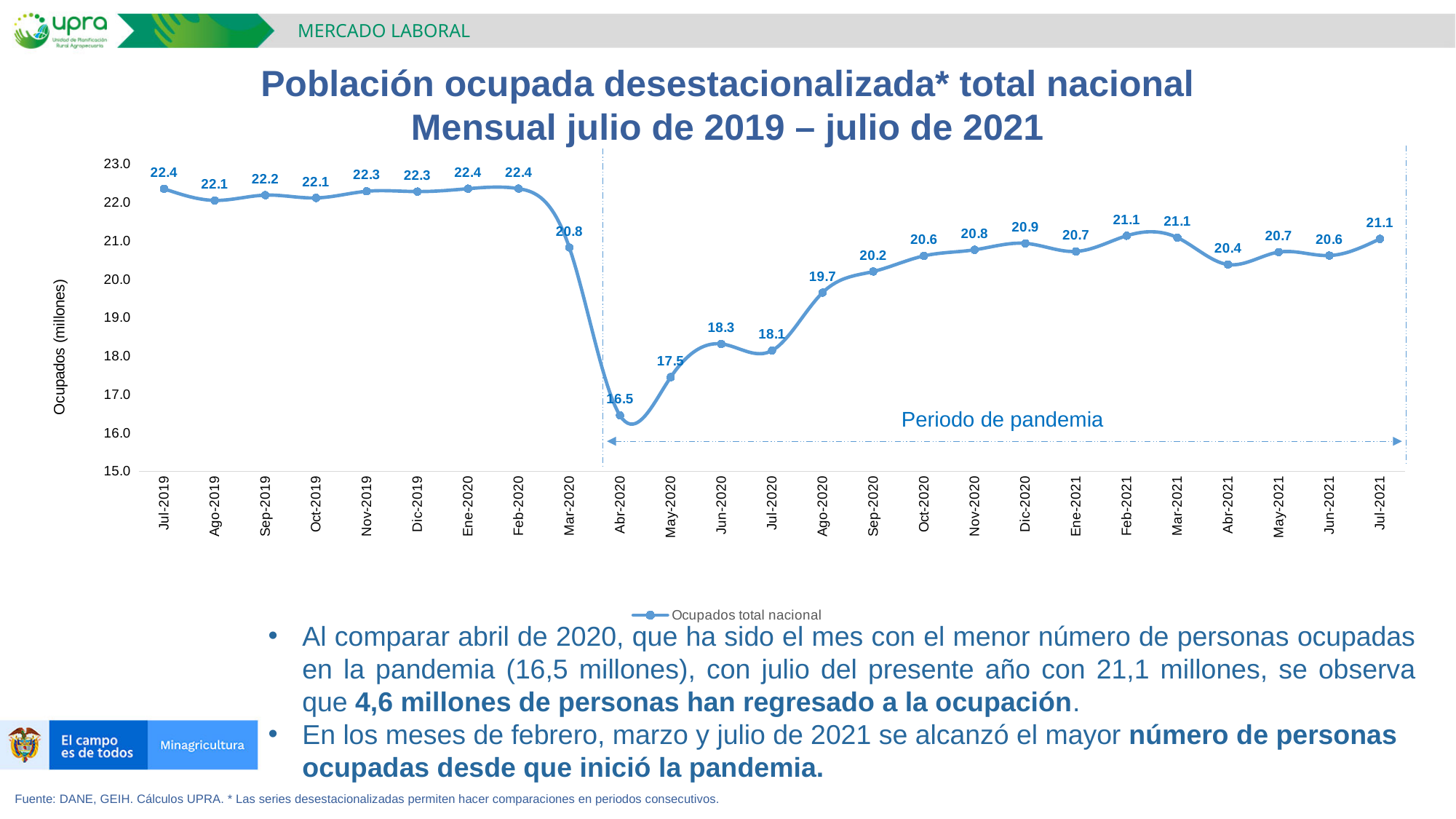
Which is larger, the value for Jun-2020 or the value for Jul-2020? Jun-2020 What is the difference between the values for Feb-2020 and Mar-2020? 1.6 How many monthly data points are plotted? 25 Which month has the lowest value? Abr-2020 Is the value for Abr-2020 greater or less than 17.0? less What is the difference between the values for Jul-2021 and Abr-2020? 4.6 What is the value for Abr-2020? 16.5 Do the values rise or fall from Abr-2020 to Dic-2020? rise What is the value for Ago-2020? 19.7 What kind of chart is this? line chart What is the value for Mar-2020? 20.8 What is the value for Jul-2021? 21.1